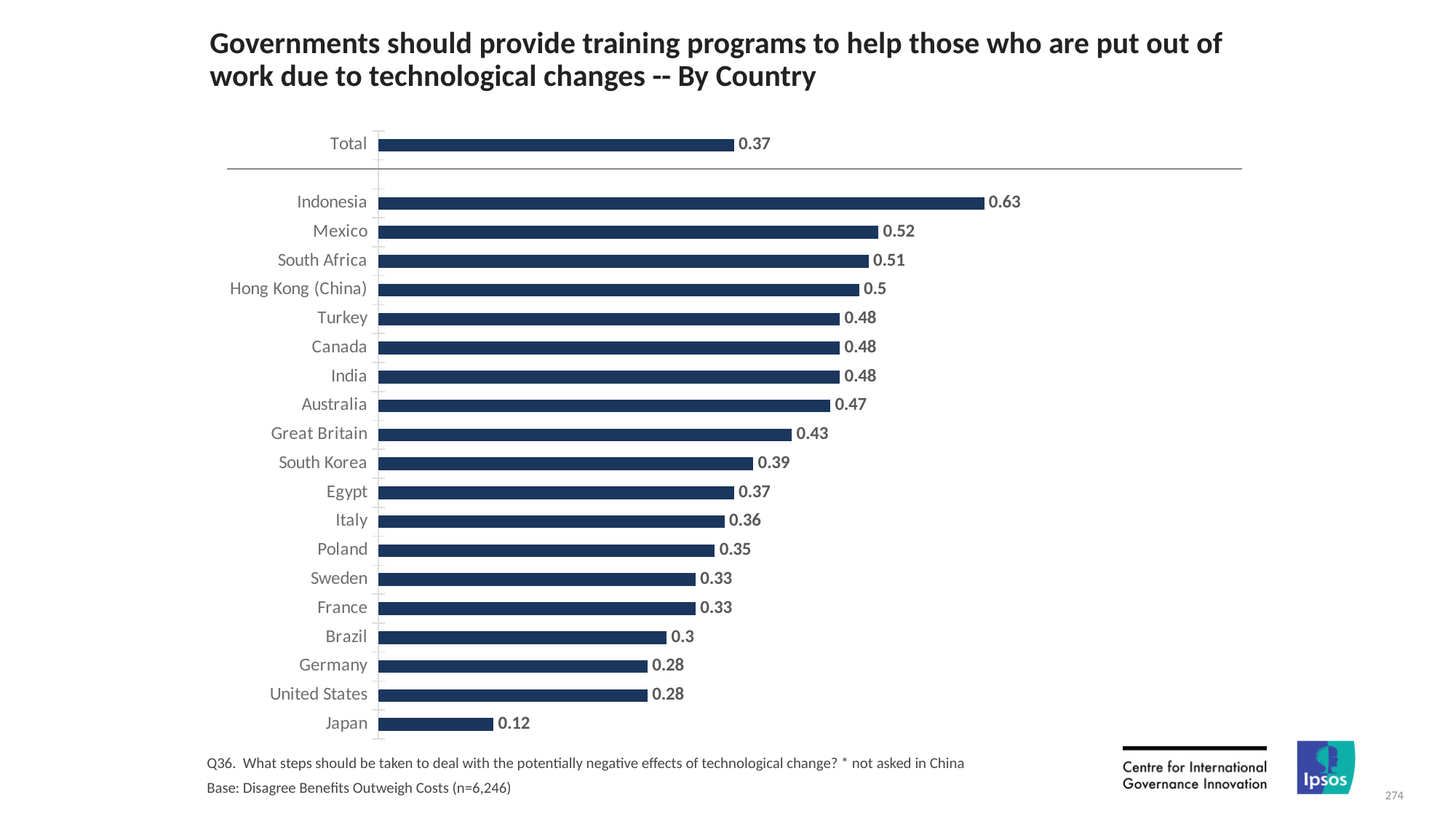
What is the value for Great Britain? 0.43 What kind of chart is shown on the slide? Bar chart What is the value for Total? 0.37 Which country has the highest value? Indonesia What is the difference between the values for Indonesia and Japan? 0.51 Which has a larger value, South Korea or Poland? South Korea How many countries are shown in the chart, excluding Total? 19 What is the value for Indonesia? 0.63 What is the title of the chart? Governments should provide training programs to help those who are put out of work due to technological changes -- By Country What is the difference between the values for Mexico and Brazil? 0.22 Which country has the lowest value? Japan What is the value for Japan? 0.12